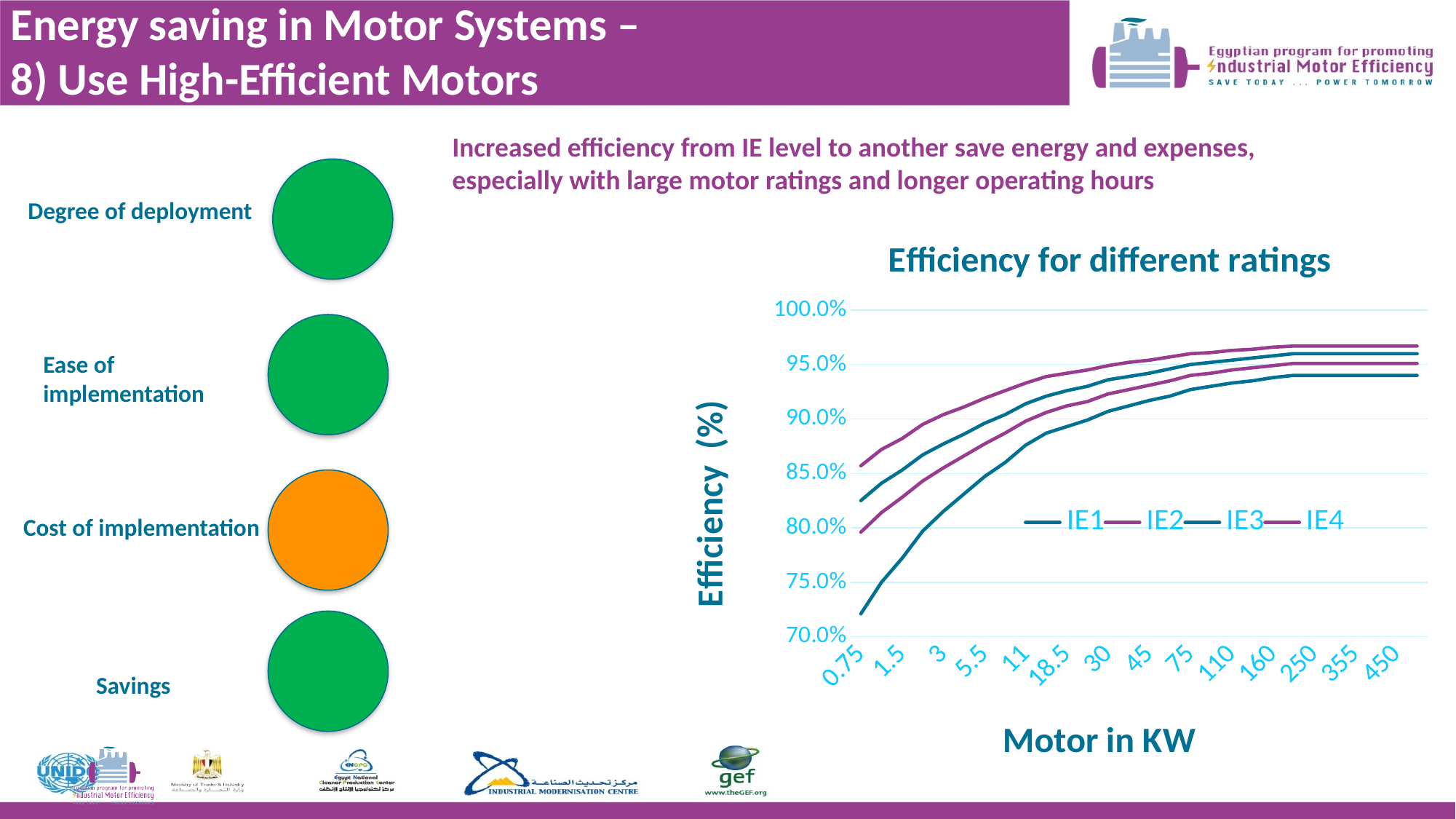
In the "Efficiency for different ratings" chart, do the efficiency values rise or fall as the motor rating in KW increases? rise In the "Efficiency for different ratings" chart, is the IE1 efficiency at 450 KW greater or less than 90.0%? greater In the "Efficiency for different ratings" chart, which series has the lowest efficiency at 0.75 KW? IE1 How many motor ratings are shown along the x axis of the "Efficiency for different ratings" chart? 14 What is the x-axis title of the "Efficiency for different ratings" chart? Motor in KW In the "Efficiency for different ratings" chart, is the IE1 efficiency at 0.75 KW greater or less than 75.0%? less In the "Efficiency for different ratings" chart, which is larger at 0.75 KW: the IE4 efficiency or the IE1 efficiency? IE4 How many series does the legend of the "Efficiency for different ratings" chart list? 4 In the "Efficiency for different ratings" chart, which series has the highest efficiency at 450 KW? IE4 In the "Efficiency for different ratings" chart, is the IE4 efficiency at 450 KW greater or less than 95.0%? greater What kind of chart is "Efficiency for different ratings"? line chart